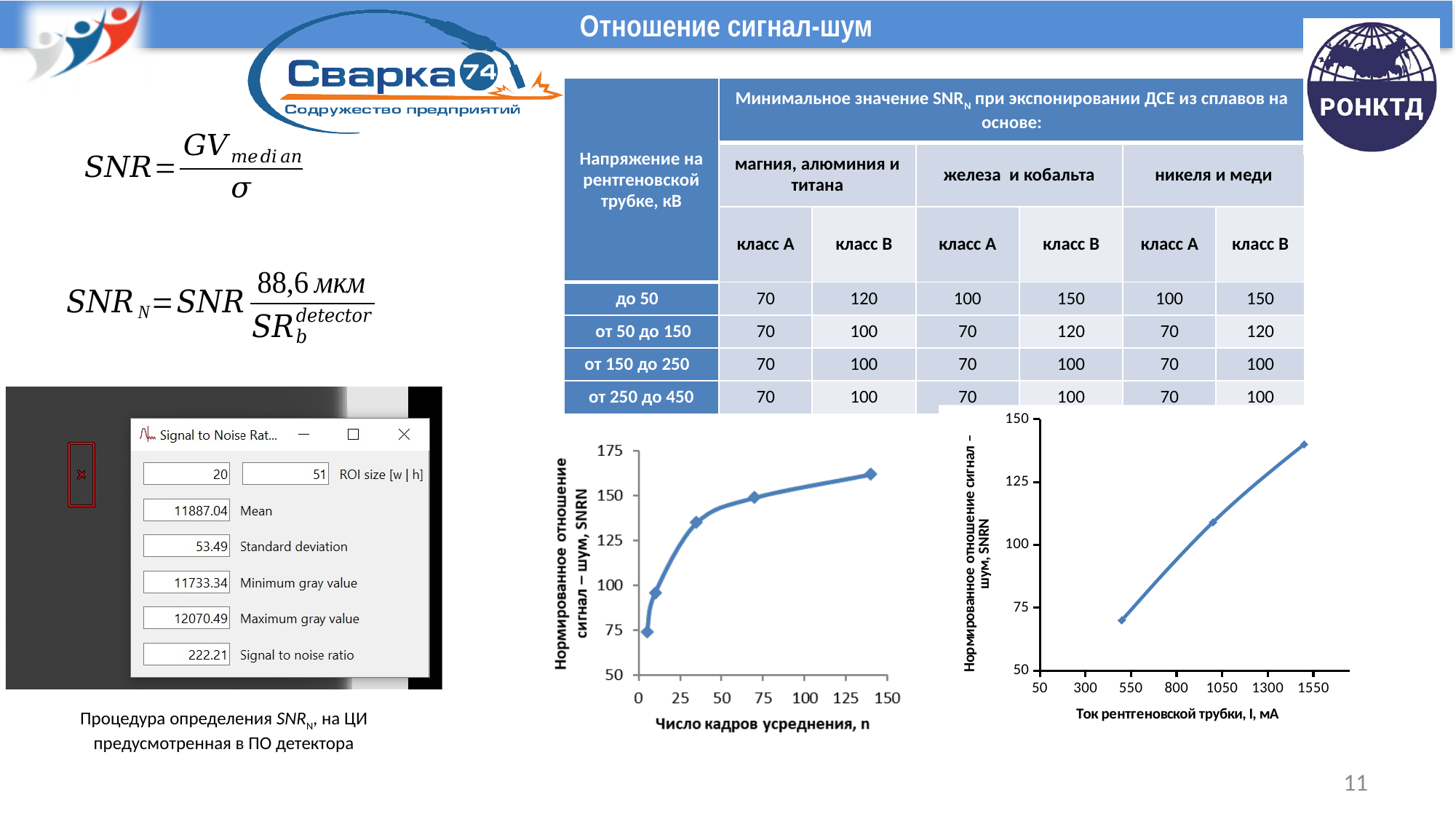
How many data points are marked on the left chart (SNRN vs number of averaging frames n)? 5 What is the x-axis title of the right chart? Ток рентгеновской трубки, I, мА In the right chart (SNRN vs X-ray tube current), is the value at the lowest current greater or less than 100? less What kind of chart is the left chart, plotting SNRN against the number of averaging frames n? line chart In the left chart (SNRN vs number of averaging frames n), do the values rise or fall as n increases? rise How many data points are marked on the right chart (SNRN vs X-ray tube current)? 3 In the left chart (SNRN vs number of averaging frames n), is the value at the largest n (around 140 frames) greater or less than 150? greater In the right chart (SNRN vs X-ray tube current I, mA), do the values rise or fall as the current increases? rise In the right chart (SNRN vs X-ray tube current), is the value at the highest current greater or less than 125? greater What kind of chart is the right chart, plotting SNRN against X-ray tube current? line chart What is the x-axis title of the left chart? Число кадров усреднения, n